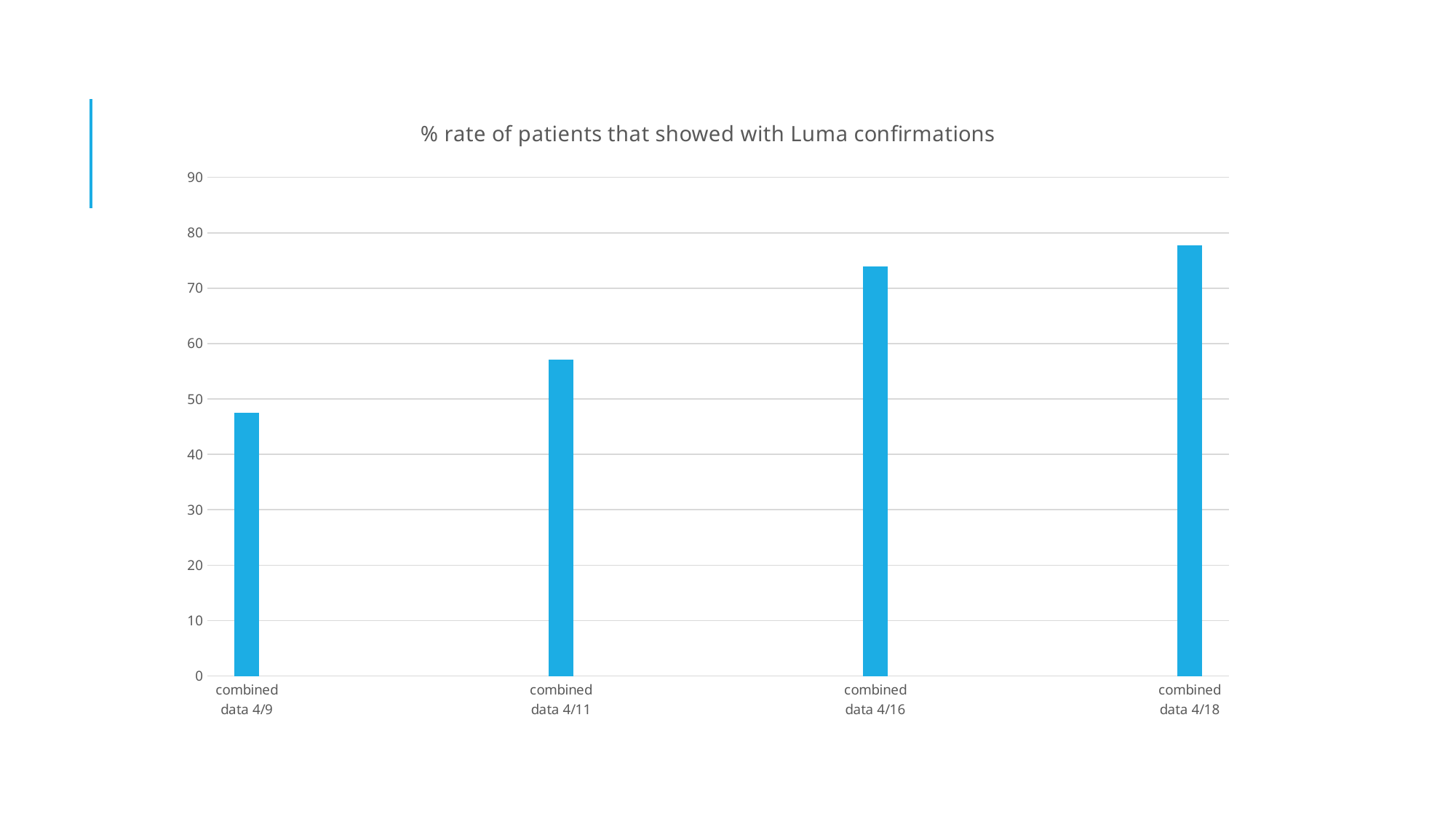
Is the value for combined data 4/11 greater or less than 50? greater What is the title of the chart? % rate of patients that showed with Luma confirmations Is the value for combined data 4/16 greater or less than 70? greater Which category has the lowest value? combined data 4/9 How many categories are plotted in the chart? 4 Which category has the highest value? combined data 4/18 Which is larger, the value for combined data 4/11 or combined data 4/16? combined data 4/16 Do the values rise or fall from combined data 4/9 to combined data 4/18? rise Is the value for combined data 4/9 greater or less than 50? less What colour are the bars in the chart? blue What kind of chart is shown on the slide? bar chart